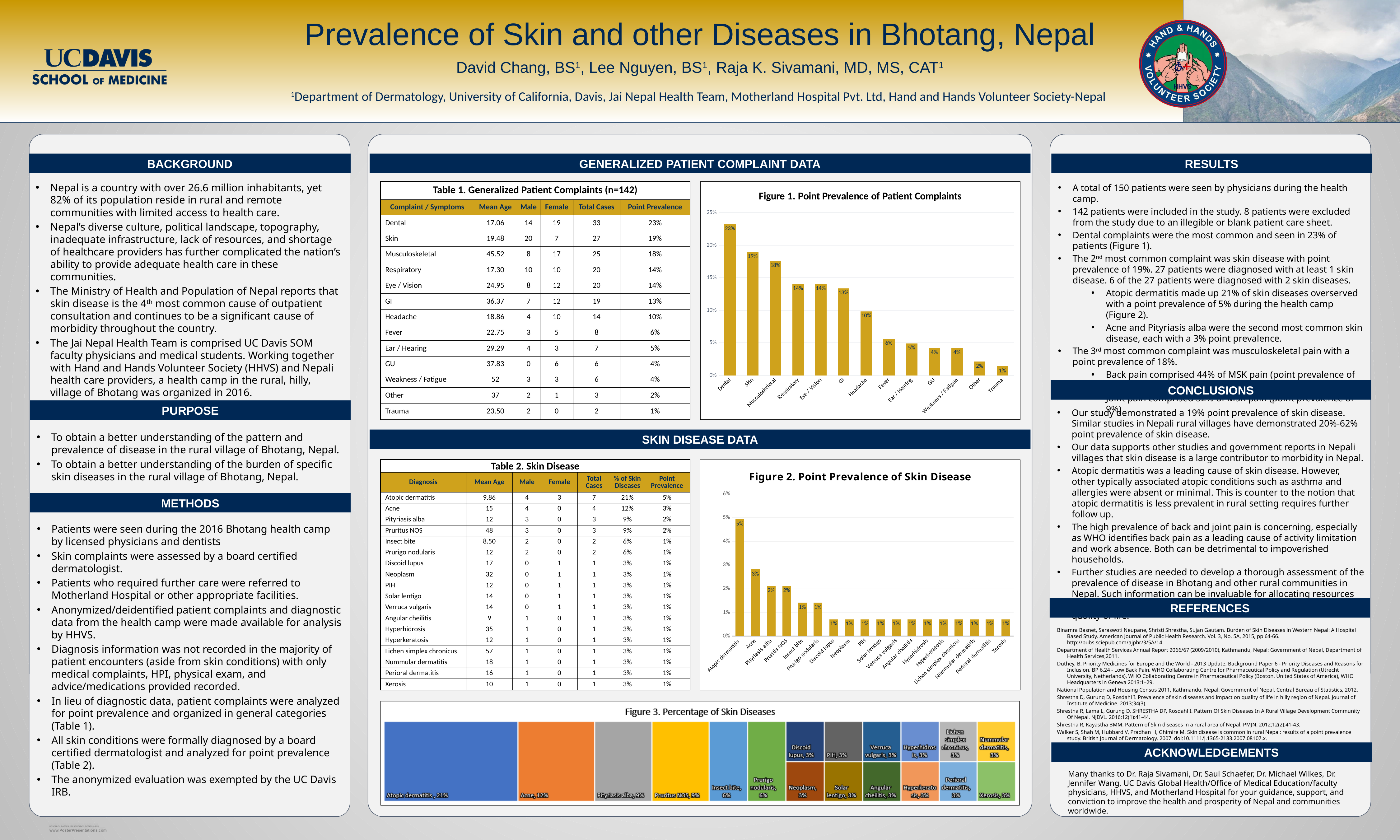
In Figure 3 (Percentage of Skin Diseases), what percentage is shown for Acne? 12% In Figure 1 (Point Prevalence of Patient Complaints), what kind of chart is shown? Bar chart In Figure 2 (Point Prevalence of Skin Disease), how many diagnoses are plotted? 18 In Figure 1 (Point Prevalence of Patient Complaints), what is the difference between the point prevalence for Skin and for Headache? 9% In Figure 2 (Point Prevalence of Skin Disease), what is the point prevalence for Atopic dermatitis? 5% In Figure 1 (Point Prevalence of Patient Complaints), how many complaint categories are plotted? 13 In Figure 3 (Percentage of Skin Diseases), which skin disease has the largest percentage? Atopic dermatitis In Figure 1 (Point Prevalence of Patient Complaints), do the values rise or fall from left to right along the x axis? Fall In Figure 2 (Point Prevalence of Skin Disease), which of Acne or Pruritus NOS has the higher point prevalence? Acne In Figure 1 (Point Prevalence of Patient Complaints), which complaint has the highest point prevalence? Dental In Figure 1 (Point Prevalence of Patient Complaints), which complaint has the lowest point prevalence? Trauma In Figure 1 (Point Prevalence of Patient Complaints), what is the point prevalence for Dental? 23%